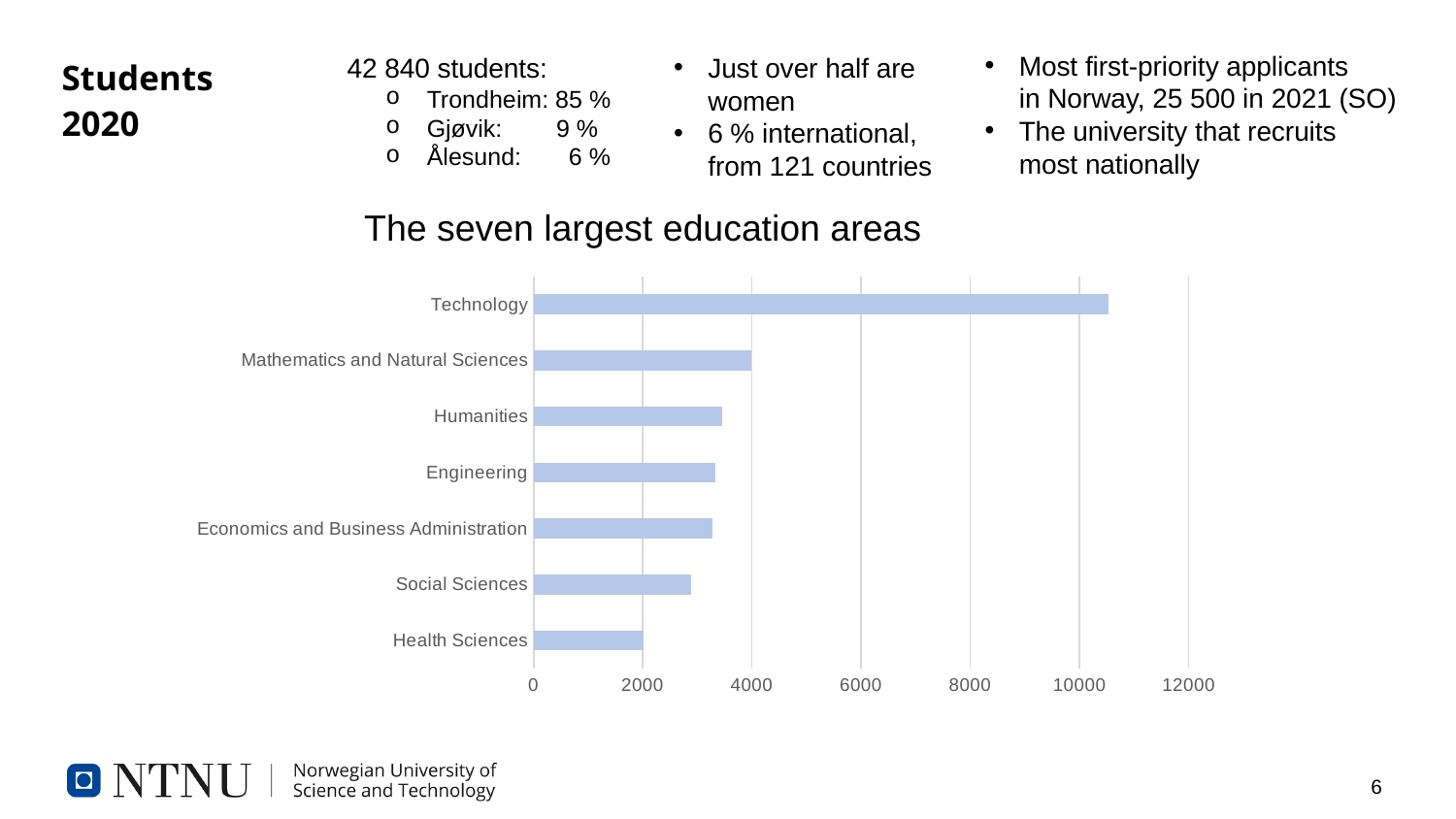
What kind of chart is shown on the slide? bar chart Is the value for Social Sciences greater or less than 2000? greater What is the title of the chart? The seven largest education areas Is the value for Engineering greater or less than 2000? greater Which education area has the lowest number of students in the chart? Health Sciences Is the value for Humanities greater or less than 4000? less Which education area has the highest number of students in the chart? Technology How many education areas are plotted in the chart? 7 Which has more students, Social Sciences or Mathematics and Natural Sciences? Mathematics and Natural Sciences Which has more students, Technology or Mathematics and Natural Sciences? Technology